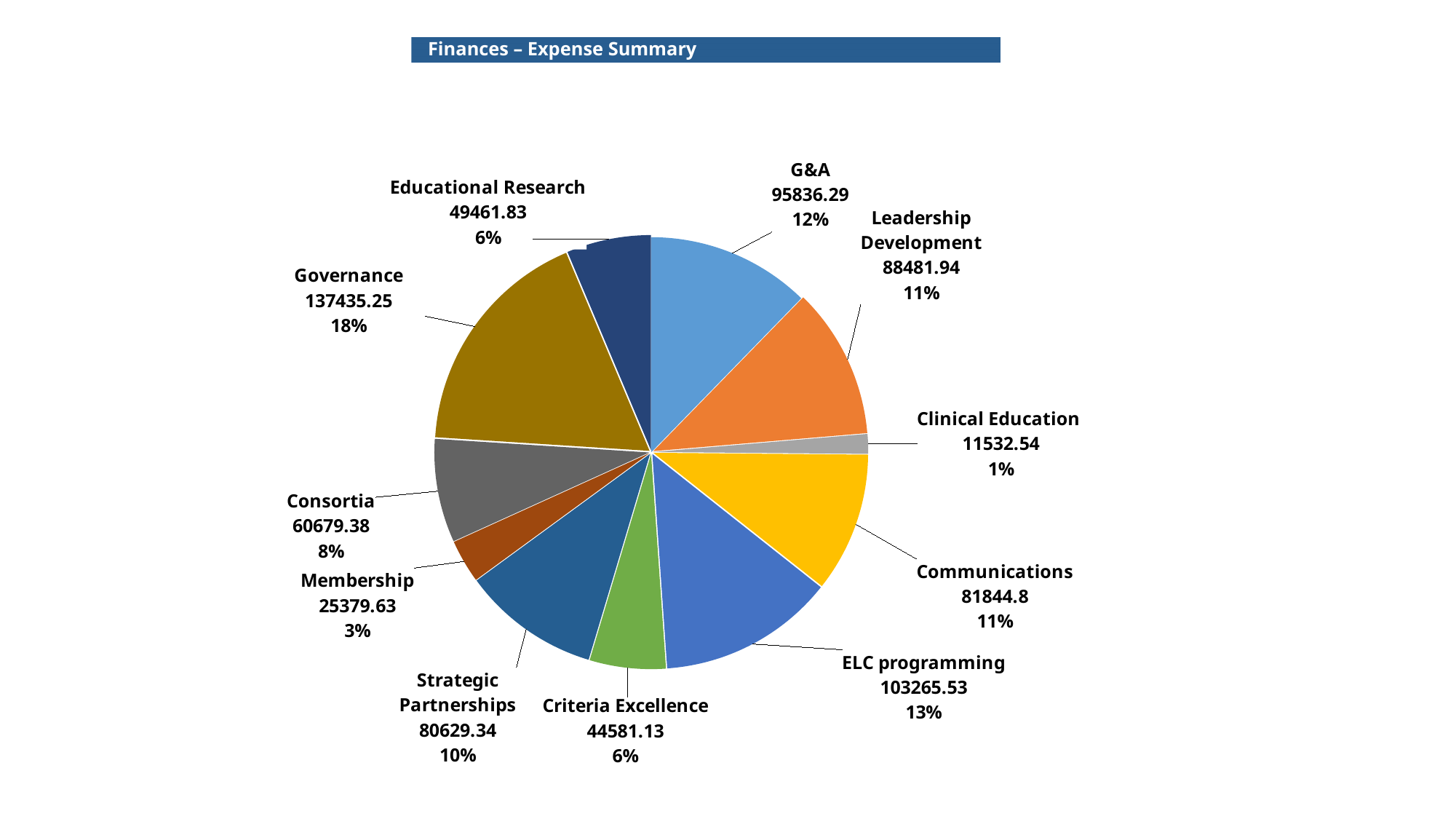
What is the difference between the values for Governance and ELC programming? 34169.72 What is the value shown for Clinical Education? 11532.54 What is the value shown for Governance? 137435.25 Which category has the largest slice of the pie? Governance What is the title shown at the top of the slide? Finances – Expense Summary Which is larger, the value for Strategic Partnerships or the value for Consortia? Strategic Partnerships What is the difference between the values for Consortia and Membership? 35299.75 What share of the pie does ELC programming represent? 13% What is the value shown for ELC programming? 103265.53 What share of the pie does Governance represent? 18% What kind of chart is shown on the slide? Pie chart What is the value shown for Criteria Excellence? 44581.13